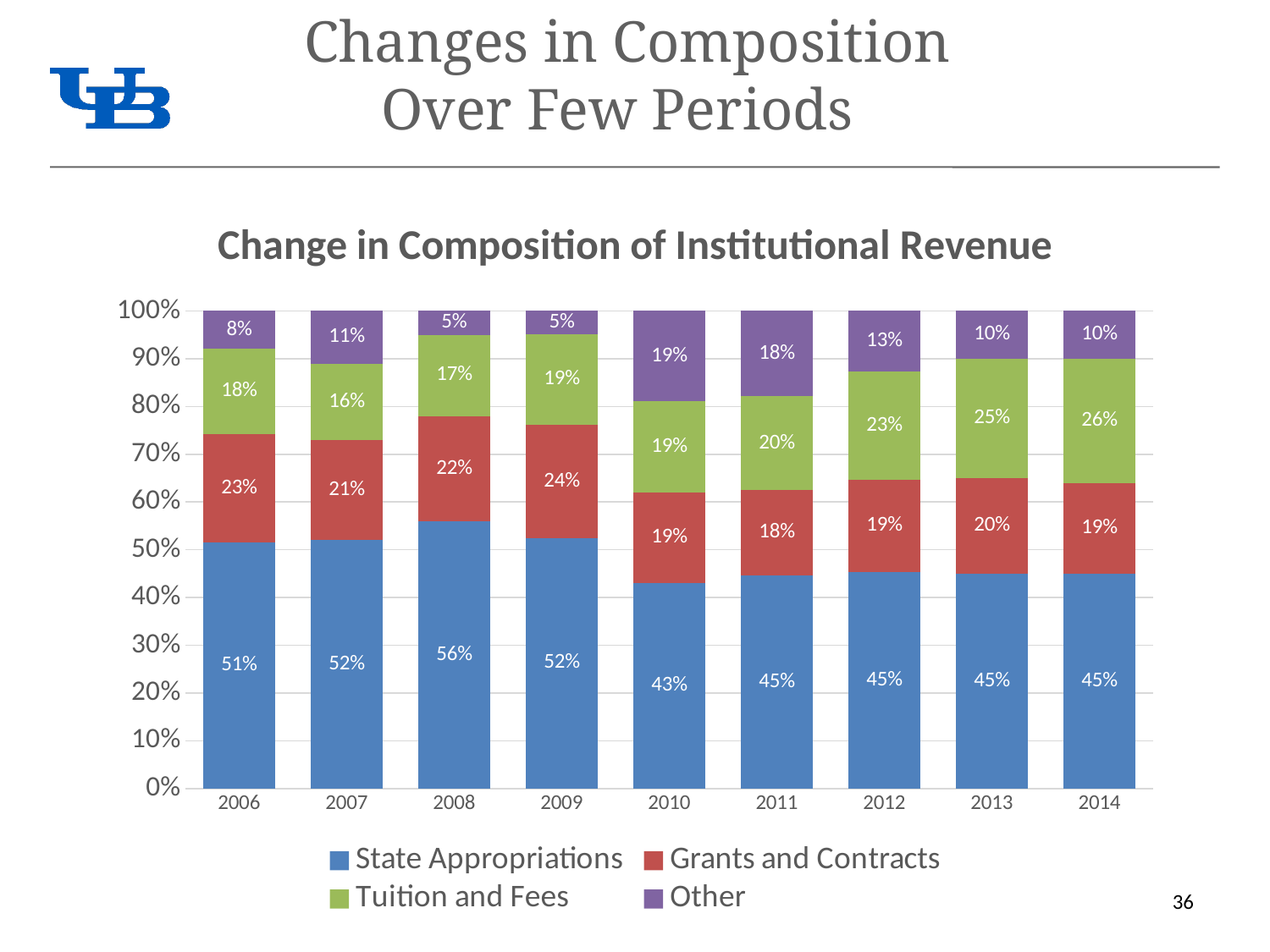
Which was larger in 2009: the Grants and Contracts share or the Tuition and Fees share? Grants and Contracts In which year was the State Appropriations share the highest? 2008 What is the title of the chart? Change in Composition of Institutional Revenue What kind of chart is shown on the slide? Stacked bar chart What share of revenue came from State Appropriations in 2008? 56% Does the Tuition and Fees share rise or fall from 2010 to 2014? Rise In which year was the State Appropriations share the lowest? 2010 By how many percentage points did the Tuition and Fees share change from 2006 to 2014? 8 percentage points How many years are shown on the x axis? 9 What share of revenue came from Tuition and Fees in 2014? 26% What share of revenue came from Other in 2010? 19% How many series does the legend list? 4